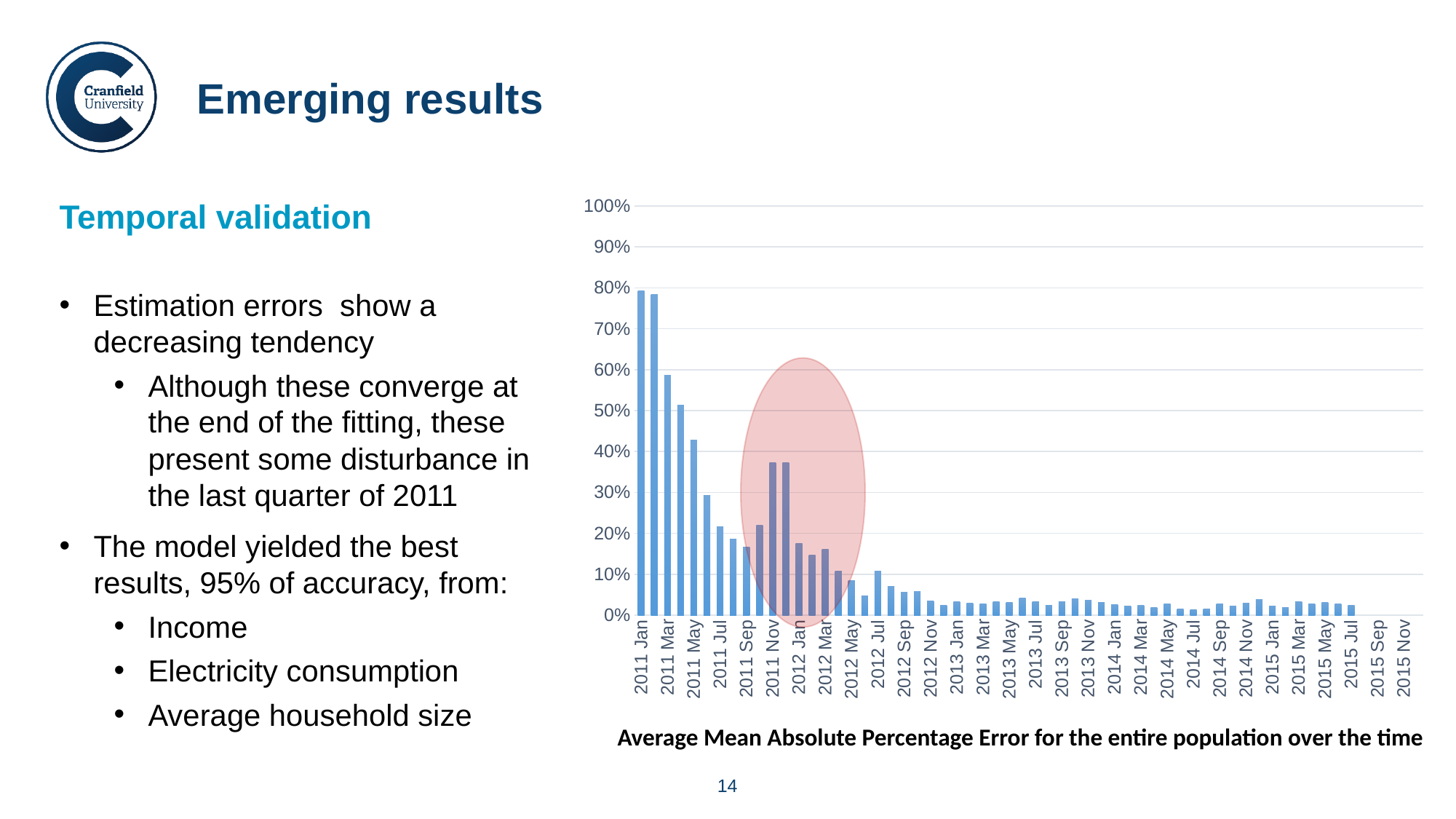
Is the value for 2011 Nov greater or less than 30%? greater What is the caption printed below the chart? Average Mean Absolute Percentage Error for the entire population over the time Is the value for 2011 Jan greater or less than 70%? greater Which is larger, the value for 2011 Jan or the value for 2011 Mar? 2011 Jan Is the value for 2011 Jul greater or less than 20%? greater Overall, do the values rise or fall from 2011 Jan to 2015 Jul along the x axis? Fall Which is larger, the value for 2011 Nov or the value for 2012 Mar? 2011 Nov What kind of chart is shown on the slide? Bar chart What is the highest value shown on the y axis of the chart? 100%